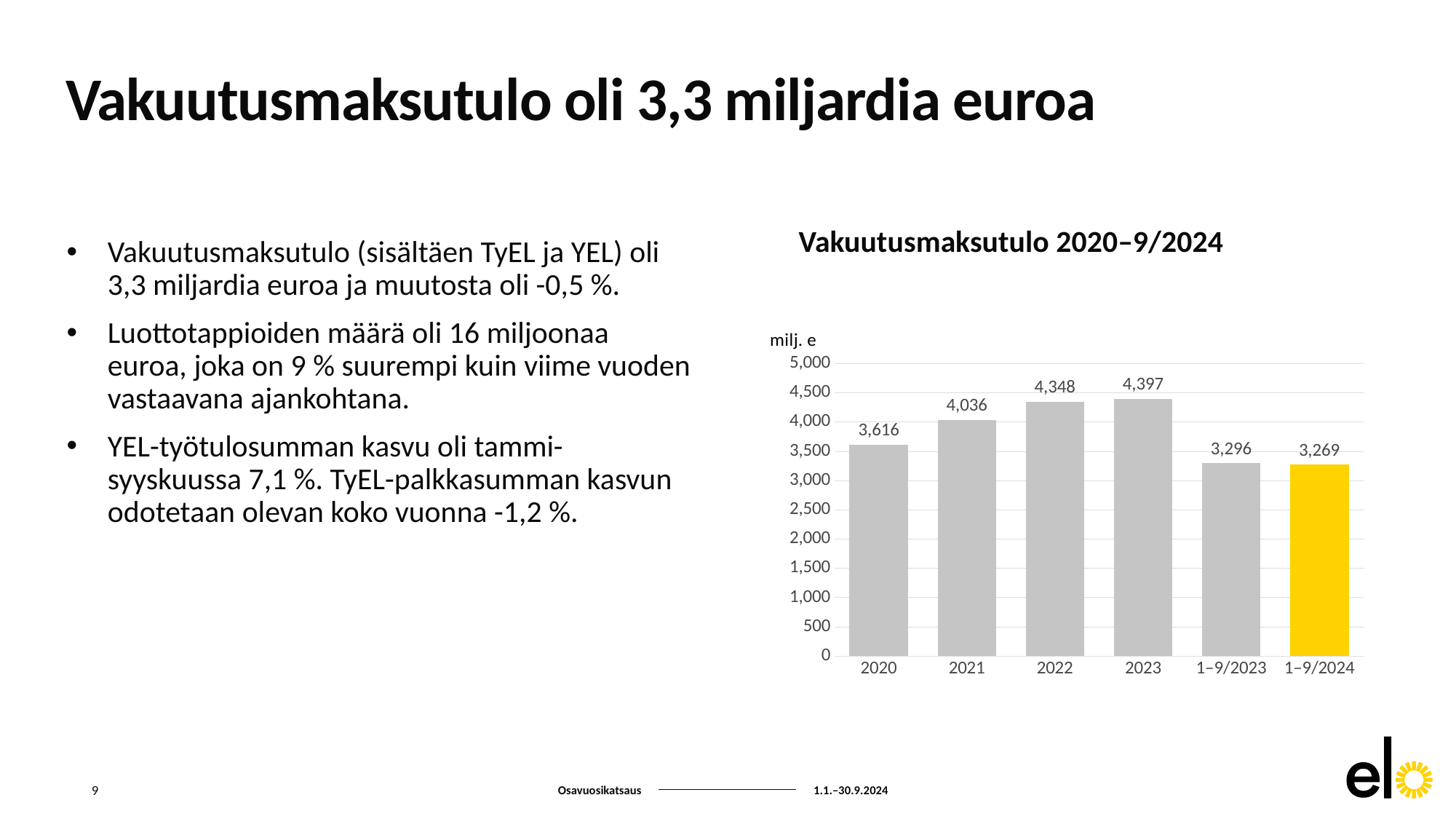
What is the title of the chart? Vakuutusmaksutulo 2020–9/2024 What is the difference between the values for 1–9/2023 and 1–9/2024? 27 What is the value for 2022 in the chart? 4,348 What is the value for 1–9/2024 in the chart? 3,269 Is the value for 2021 greater or less than 4,000? greater How many categories are shown on the x axis of the chart? 6 Which category has the highest value in the chart? 2023 What is the value for 2020 in the chart? 3,616 What is the difference between the values for 2023 and 2022? 49 Which is larger, the value for 2021 or the value for 2020? 2021 Which category has the lowest value in the chart? 1–9/2024 What kind of chart is shown on the slide? bar chart